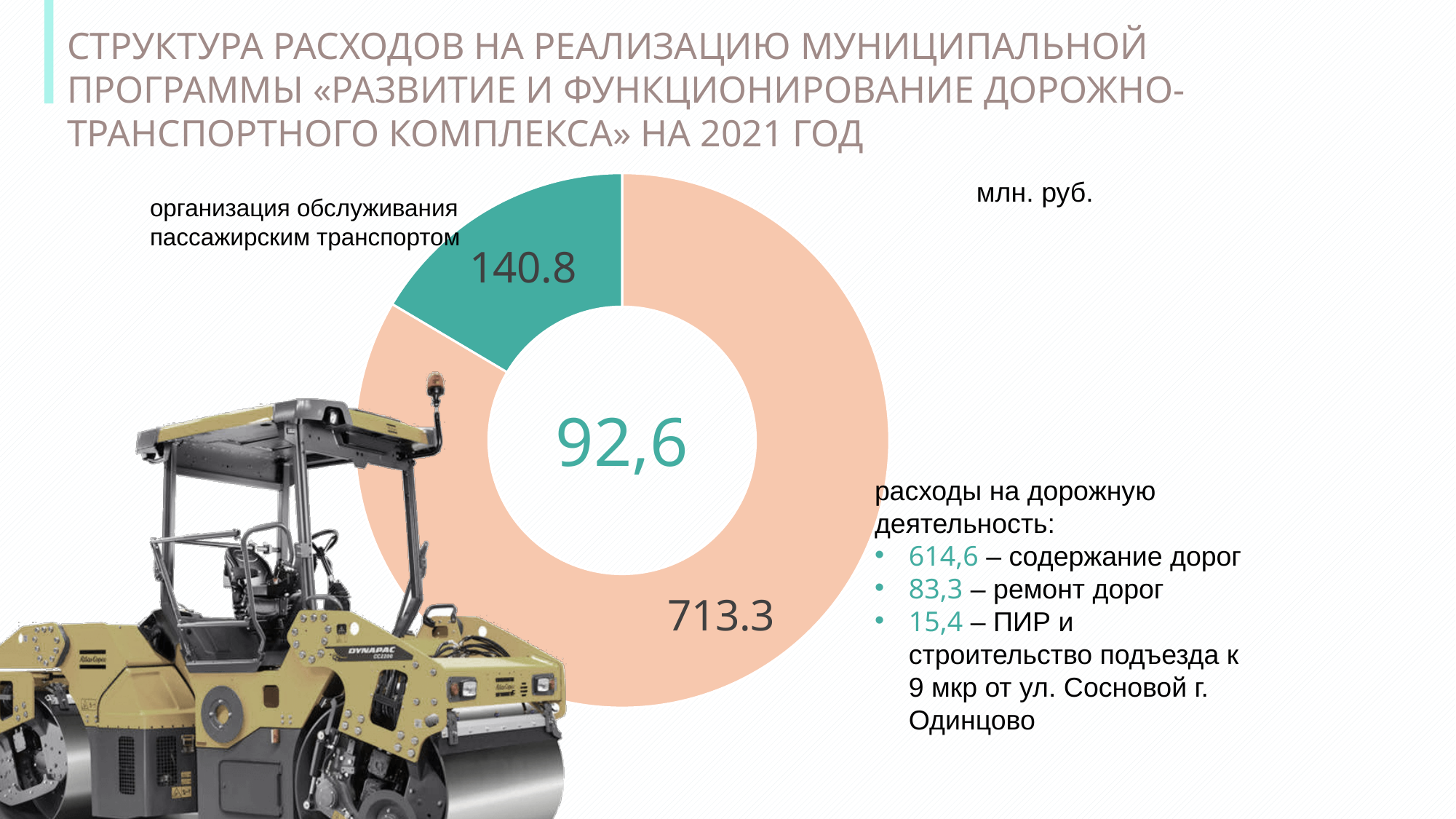
What is the total of the two slice values shown on the chart? 854.1 How many slices does the donut chart have? 2 Which category has the largest slice of the donut chart? расходы на дорожную деятельность What is the value of the slice for расходы на дорожную деятельность? 713.3 What is the difference between the value for расходы на дорожную деятельность and the value for организация обслуживания пассажирским транспортом? 572.5 What number is printed in the centre of the donut chart? 92,6 Which category has the smallest slice of the donut chart? организация обслуживания пассажирским транспортом What unit of measurement is indicated for the chart values? млн. руб. What colour is the slice for организация обслуживания пассажирским транспортом? teal (green) What is the value of the slice for организация обслуживания пассажирским транспортом? 140.8 What type of chart is shown on the slide? donut (pie) chart Which is larger: the value for расходы на дорожную деятельность or the value for организация обслуживания пассажирским транспортом? расходы на дорожную деятельность